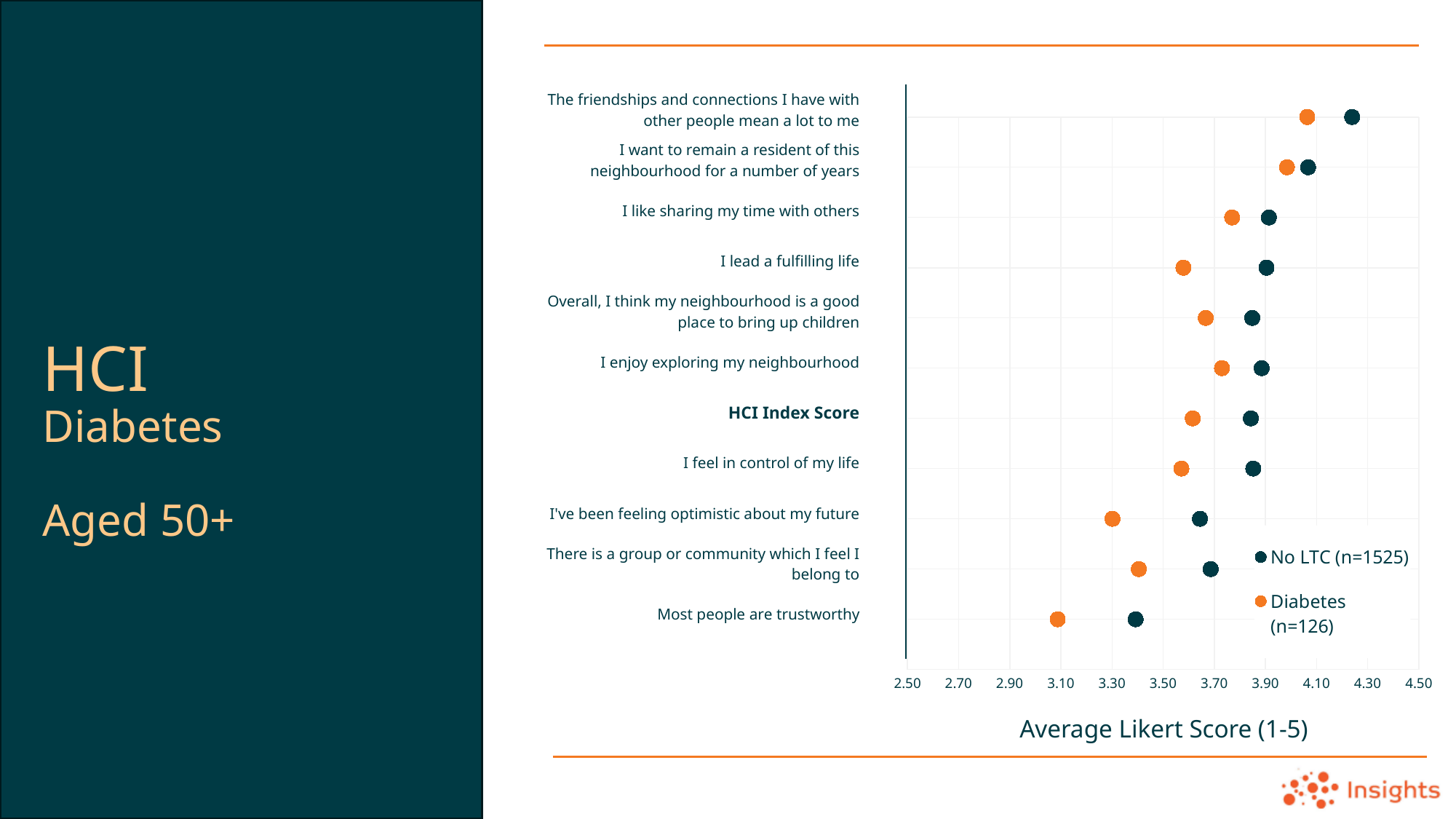
For 'I lead a fulfilling life', which series has the higher score, No LTC or Diabetes? No LTC What sample size is shown in the legend for the Diabetes series? n=126 Which statement has the lowest score for the Diabetes series? Most people are trustworthy What kind of chart is shown on the slide? Dot plot How many statements (categories) are plotted on the chart? 11 Which statement has the highest score for the No LTC series? The friendships and connections I have with other people mean a lot to me Is the No LTC value for 'Most people are trustworthy' greater or less than 3.50? less Is the Diabetes value for 'HCI Index Score' greater or less than 3.50? greater Is the No LTC value for 'The friendships and connections I have with other people mean a lot to me' greater or less than 4.10? greater How many series does the legend list? 2 What is the title of the x axis? Average Likert Score (1-5)